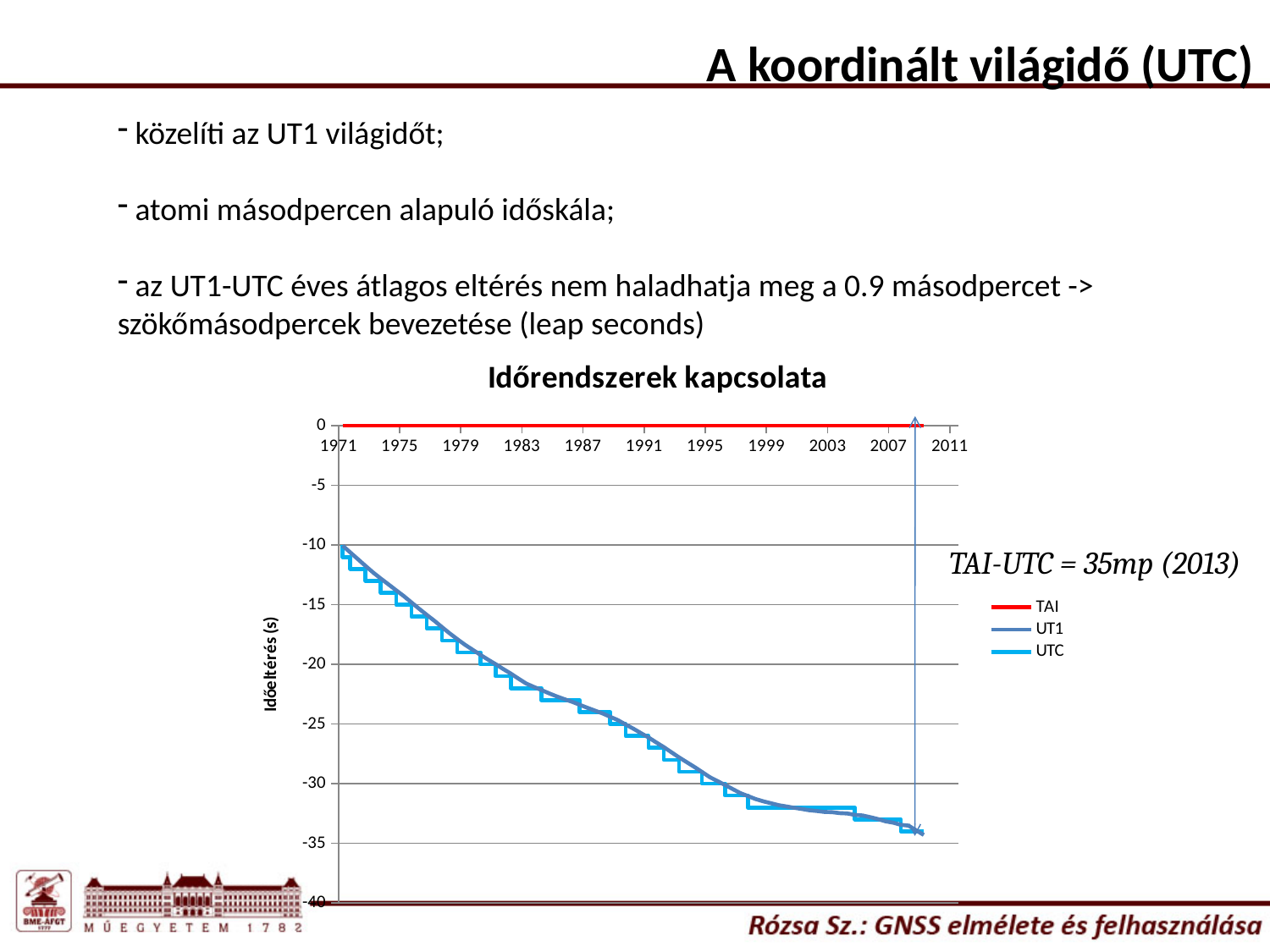
What is the label of the vertical axis of the chart? Időeltérés (s) Is the value for UTC in 2007 greater or less than -30? less Do the UT1 values rise or fall along the x axis? fall In 1999, which series has the larger value, TAI or UTC? TAI How many series does the legend of the chart list? 3 What is the title of the chart? Időrendszerek kapcsolata Is the value for UTC in 1991 greater or less than -20? less Do the UTC values rise or fall from 1971 to 2011? fall Is the value for UT1 in 1971 greater or less than -15? greater What kind of chart is shown on the slide? line chart Which series has the highest values throughout the chart? TAI What value does the TAI series hold across the whole chart? 0